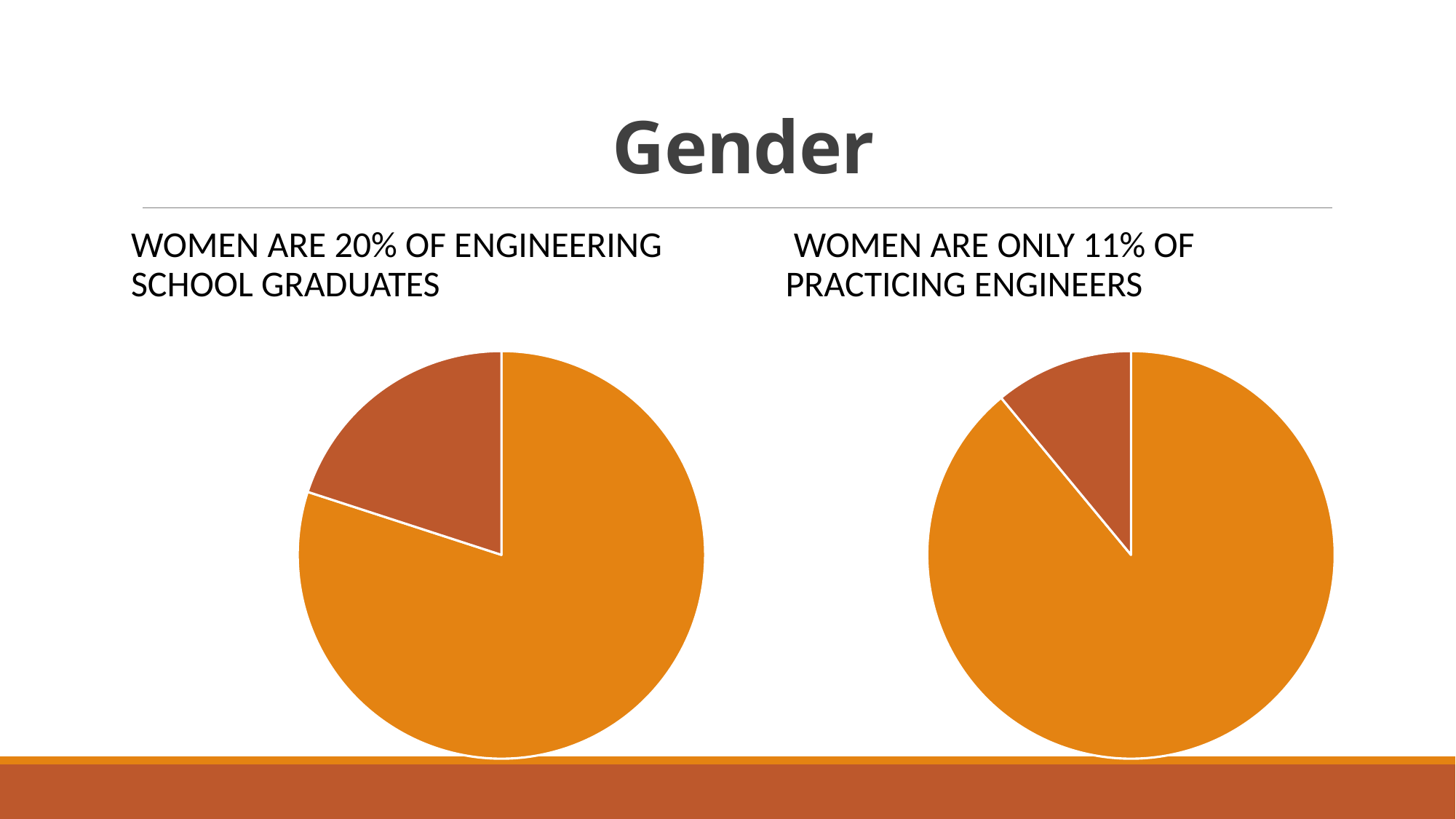
How many slices does the left pie chart have? 2 According to the heading above the left pie chart, what share of engineering school graduates are women? 20% In the right pie chart, which slice is larger, the dark red-brown slice or the orange slice? the orange slice In the left pie chart, which slice is larger, the dark red-brown slice or the orange slice? the orange slice Is the smaller slice of the left pie chart greater or less than 50% of the pie? less How many pie charts are on the slide? 2 Which pie chart has the smaller dark red-brown slice, the left one or the right one? the right one What is the title of the slide? Gender According to the heading above the right pie chart, what share of practicing engineers are women? 11% What kind of chart is shown on the right side of the slide? pie chart What kind of chart is shown on the left side of the slide? pie chart How many slices does the right pie chart have? 2